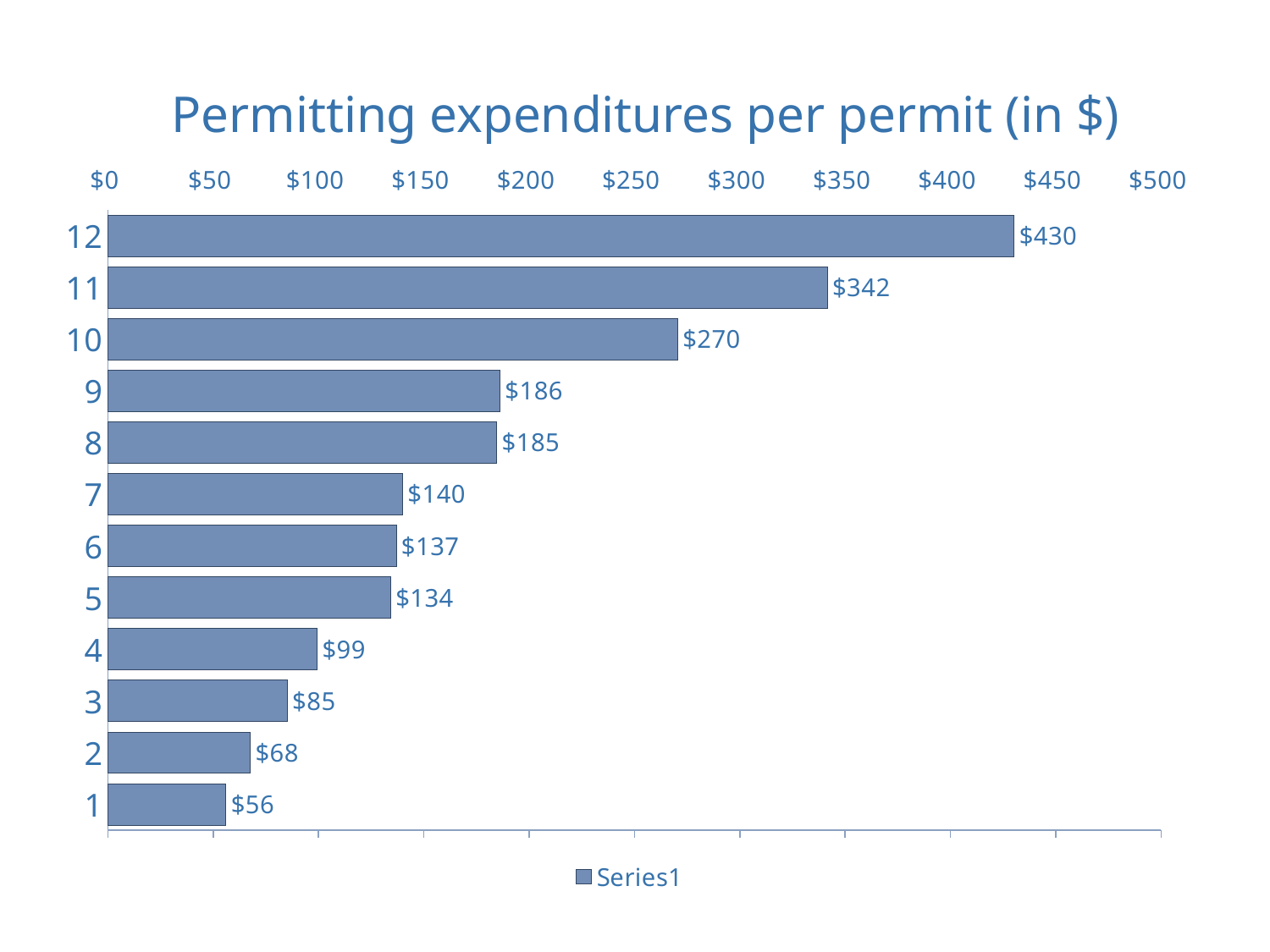
What is the value for category 12? $430 How many series does the legend list? 1 What is the value for category 5? $134 Is the value for category 10 greater or less than $250? greater How many categories are shown in the chart? 12 Which category has the lowest value? 1 What kind of chart is shown on the slide? bar chart What is the difference between the values for category 11 and category 10? $72 Which is larger, the value for category 9 or category 7? 9 What is the title of the chart? Permitting expenditures per permit (in $) What is the value for category 2? $68 Which category has the highest value? 12